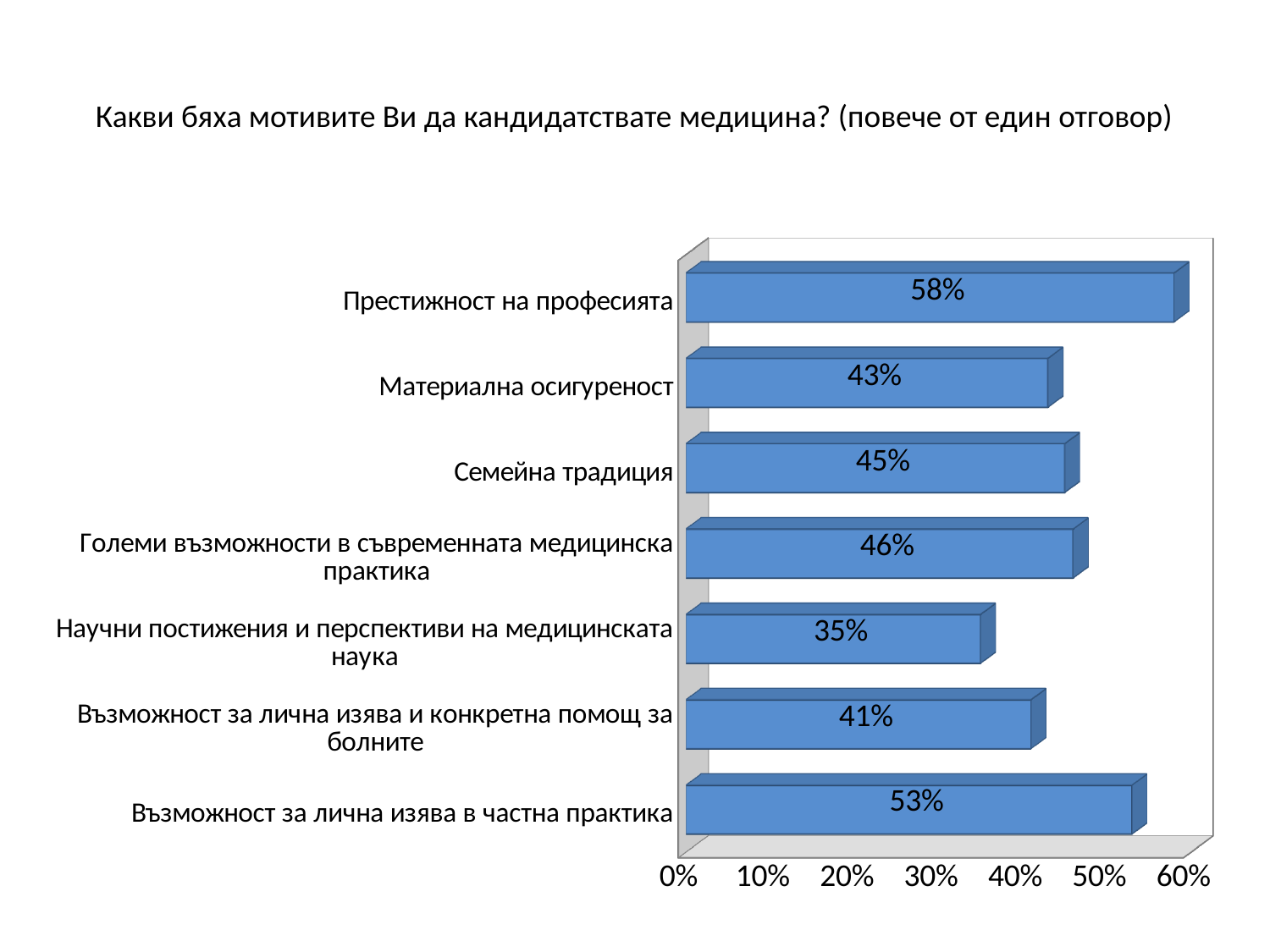
What is the difference between the values for Престижност на професията and Възможност за лична изява в частна практика? 5% Which category has the lowest value? Научни постижения и перспективи на медицинската наука Which is larger: the value for Големи възможности в съвременната медицинска практика or the value for Възможност за лична изява и конкретна помощ за болните? Големи възможности в съвременната медицинска практика What is the value for Научни постижения и перспективи на медицинската наука? 35% What is the value for Семейна традиция? 45% What is the value for Възможност за лична изява в частна практика? 53% What is the value for Престижност на професията? 58% What is the title of the chart? Какви бяха мотивите Ви да кандидатствате медицина? (повече от един отговор) Which category has the highest value? Престижност на професията What is the value for Материална осигуреност? 43% How many categories are shown in the chart? 7 What kind of chart is shown on the slide? Bar chart